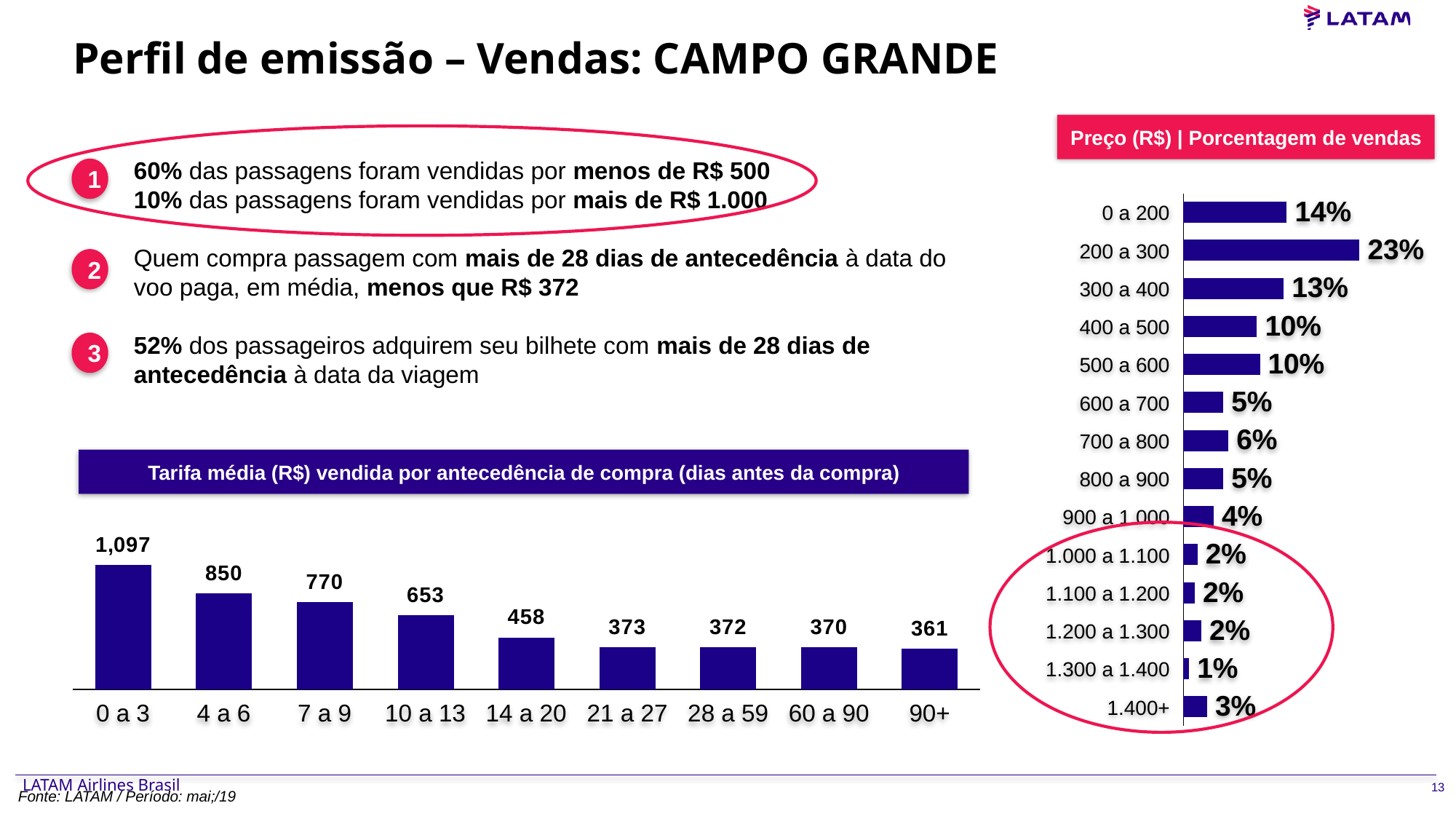
In the 'Preço (R$) | Porcentagem de vendas' chart, which is larger: the share for 0 a 200 or for 300 a 400? 0 a 200 In the 'Preço (R$) | Porcentagem de vendas' chart, which price range has the highest share of sales? 200 a 300 In the 'Preço (R$) | Porcentagem de vendas' chart, what percentage of sales falls in the 200 a 300 price range? 23% In the 'Tarifa média (R$) vendida por antecedência de compra' chart, what is the difference between the values for 4 a 6 and 7 a 9 days? 80 In the 'Tarifa média (R$) vendida por antecedência de compra' chart, which purchase-advance category has the lowest average fare? 90+ What kind of chart is the 'Tarifa média (R$) vendida por antecedência de compra' chart? bar chart In the 'Tarifa média (R$) vendida por antecedência de compra' chart, do the values rise or fall as the purchase advance increases along the x axis? fall In the 'Tarifa média (R$) vendida por antecedência de compra' chart, what is the average fare for tickets bought 0 a 3 days before? 1,097 In the 'Preço (R$) | Porcentagem de vendas' chart, which price range has the lowest share of sales? 1.300 a 1.400 In the 'Tarifa média (R$) vendida por antecedência de compra' chart, how many purchase-advance categories are shown? 9 In the 'Tarifa média (R$) vendida por antecedência de compra' chart, what is the value for 14 a 20 days? 458 In the 'Preço (R$) | Porcentagem de vendas' chart, how many price ranges are listed? 14